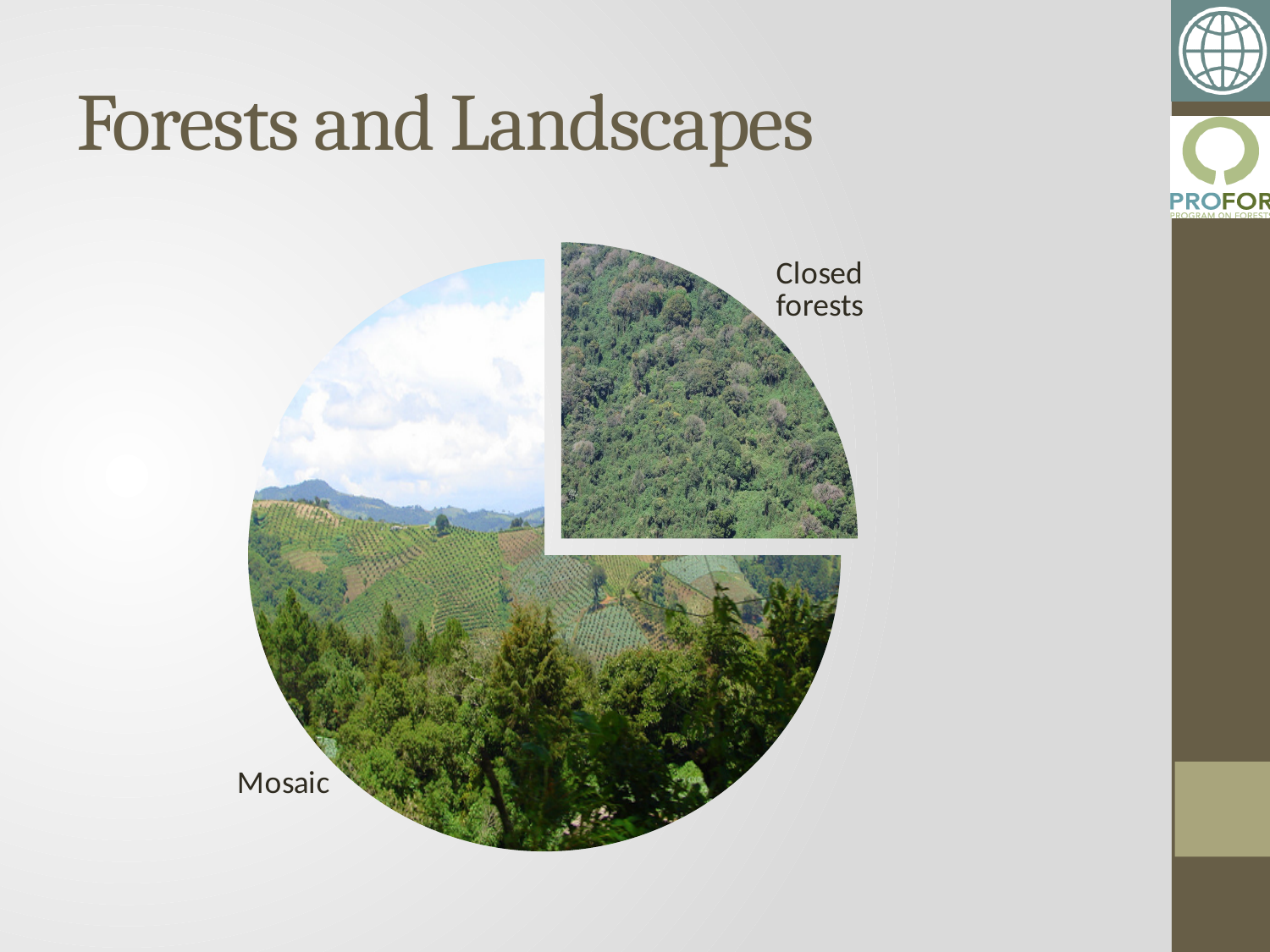
What kind of chart is shown on the slide? pie chart Which slice of the pie chart is the smallest? Closed forests What is the title of the slide containing the pie chart? Forests and Landscapes Which slice of the pie chart is pulled out (exploded) from the rest of the pie? Closed forests Which is larger in the pie chart, Mosaic or Closed forests? Mosaic How many slices does the pie chart have? 2 Which slice of the pie chart is the largest? Mosaic